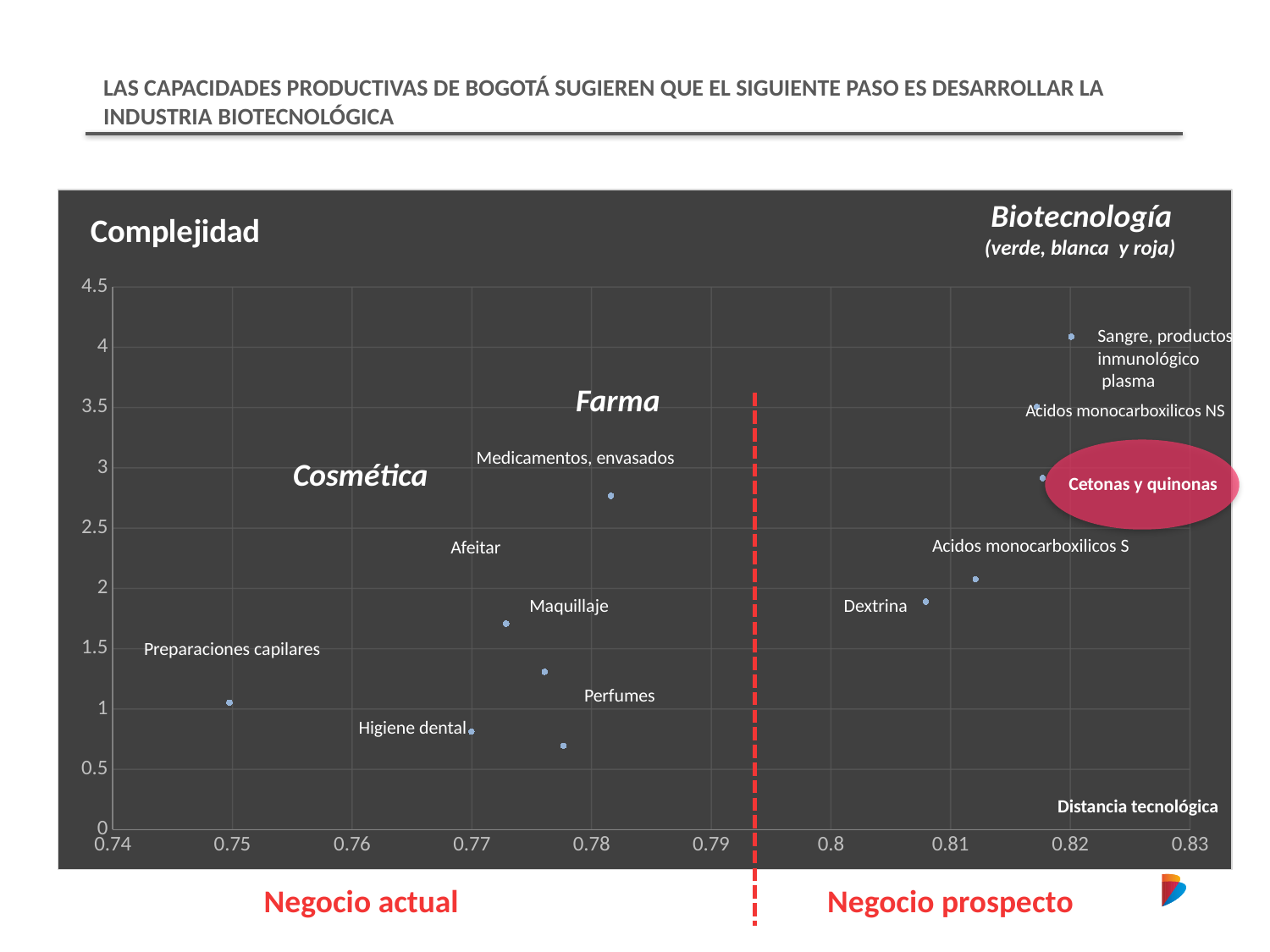
Which point has the lowest Complejidad value? Perfumes Is the Complejidad value for Afeitar greater or less than 1.5? greater How many data points are plotted on the chart? 11 Which has a higher Complejidad value, Acidos monocarboxilicos S or Dextrina? Acidos monocarboxilicos S Which point has the lowest Distancia tecnológica value? Preparaciones capilares Which point on the chart is highlighted with a red oval? Cetonas y quinonas Which point has the highest Complejidad value? Sangre, productos inmunológico plasma Is the Complejidad value for Medicamentos, envasados greater or less than 3? less Is the Complejidad value for Dextrina greater or less than 2? less Which has a higher Complejidad value, Medicamentos, envasados or Afeitar? Medicamentos, envasados What kind of chart is shown on the slide? scatter chart